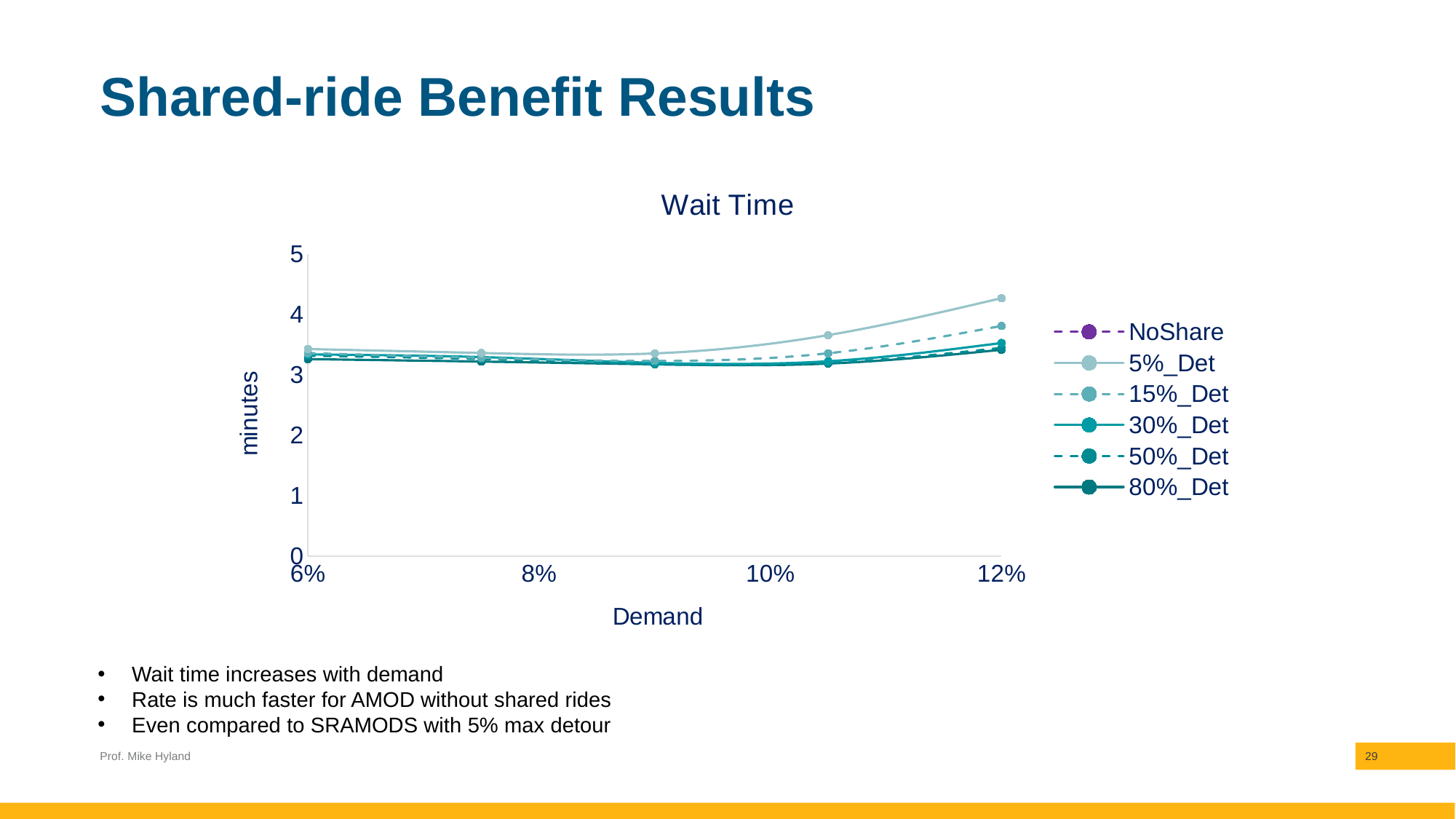
Is the value for 5%_Det at 6% demand greater or less than 4? less How many data points are plotted for the 5%_Det series? 5 Which series has the highest value at 12% demand? 5%_Det How many series does the legend list? 6 Is the value for 5%_Det at 12% demand greater or less than 4? greater What is the title of the chart? Wait Time Is the value for 80%_Det at 12% demand greater or less than 4? less What is the label of the y axis? minutes Does the 5%_Det series rise or fall from 8% to 12% demand? rise What kind of chart is shown on the slide? line chart At 12% demand, which is larger: the value for 5%_Det or the value for 80%_Det? 5%_Det